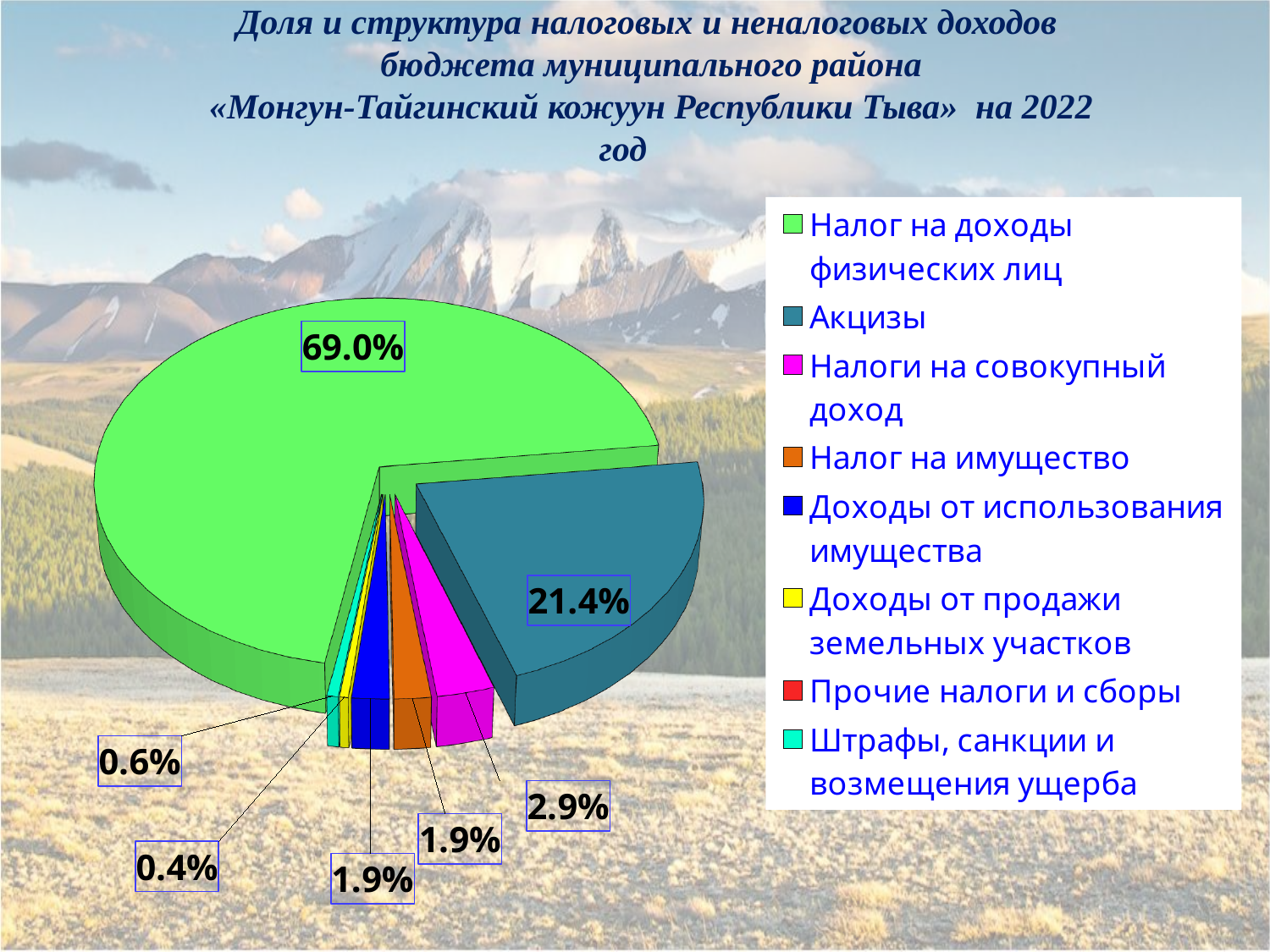
What share of the budget revenue is Налог на доходы физических лиц? 69.0% What share is shown for Акцизы? 21.4% What share is shown for Налог на имущество? 1.9% What colour is the slice for Налог на доходы физических лиц? Green Which category has the largest slice of the pie? Налог на доходы физических лиц What share is shown for Налоги на совокупный доход? 2.9% What is the combined share of Налог на доходы физических лиц and Акцизы? 90.4% Which is larger, the share for Акцизы or the share for Налоги на совокупный доход? Акцизы By how many percentage points does Налог на доходы физических лиц exceed Акцизы? 47.6 percentage points What share is shown for Доходы от использования имущества? 1.9% How many categories does the legend list? 8 What kind of chart is shown on the slide? Pie chart